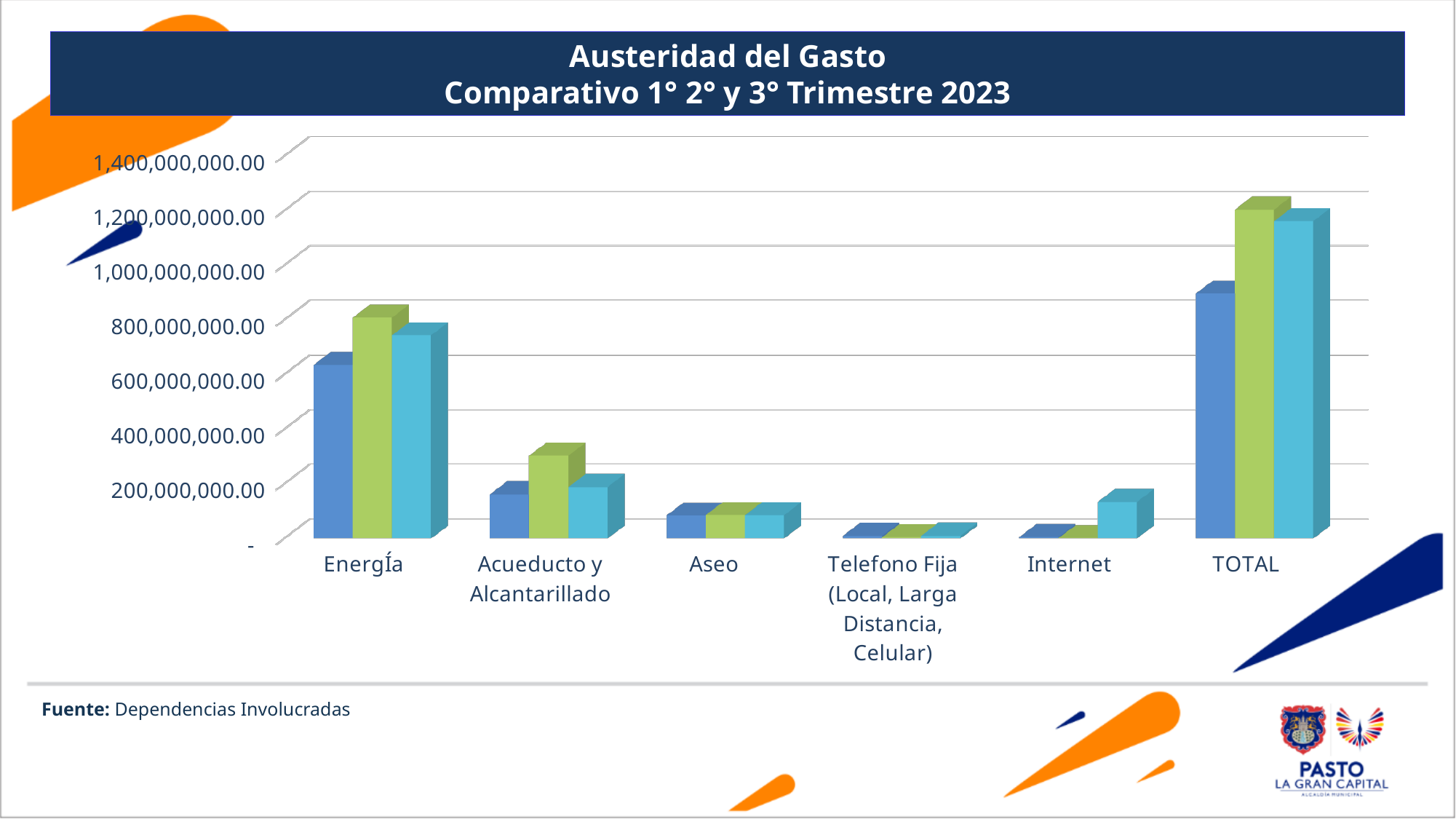
Which category has larger values, Acueducto y Alcantarillado or Internet? Acueducto y Alcantarillado Which category has the tallest bars in the chart? TOTAL Which category has larger values, EnergÍa or Aseo? EnergÍa Are the values for Aseo greater or less than 200,000,000.00? less Is the value of the dark blue (first) bar for TOTAL greater or less than 1,000,000,000.00? less Is the value of the green (second) bar for Acueducto y Alcantarillado greater or less than 400,000,000.00? less Which category has the lowest values in the chart? Telefono Fija (Local, Larga Distancia, Celular) Excluding TOTAL, which category has the highest values in the chart? EnergÍa How many categories are shown along the x axis of the chart? 6 What kind of chart is shown on the slide? bar chart What is the title of the chart on the slide? Austeridad del Gasto Comparativo 1° 2° y 3° Trimestre 2023